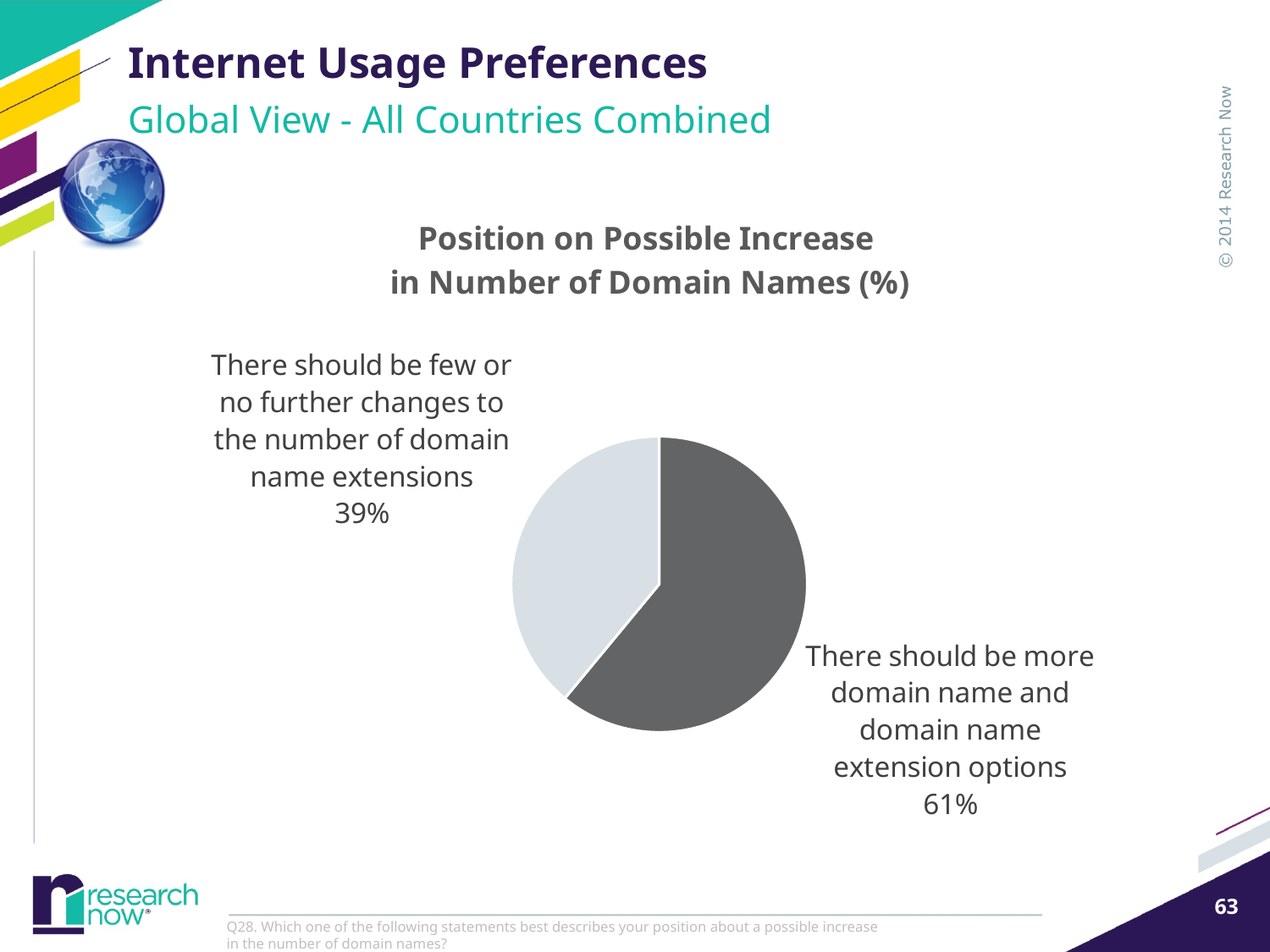
How many slices does the pie chart have? 2 Is the share for 'There should be more domain name and domain name extension options' larger or smaller than the share for 'There should be few or no further changes'? larger What percentage of respondents said there should be few or no further changes to the number of domain name extensions? 39% What percentage of respondents said there should be more domain name and domain name extension options? 61% What kind of chart is shown on the slide? pie chart What share of the pie does the 'few or no further changes' slice represent? 39% Which slice is shown in the darker grey colour? There should be more domain name and domain name extension options Which position has the larger share of the pie? There should be more domain name and domain name extension options Which position has the smaller share of the pie? There should be few or no further changes to the number of domain name extensions What is the chart's title? Position on Possible Increase in Number of Domain Names (%) What is the difference in percentage points between the two positions shown in the pie chart? 22